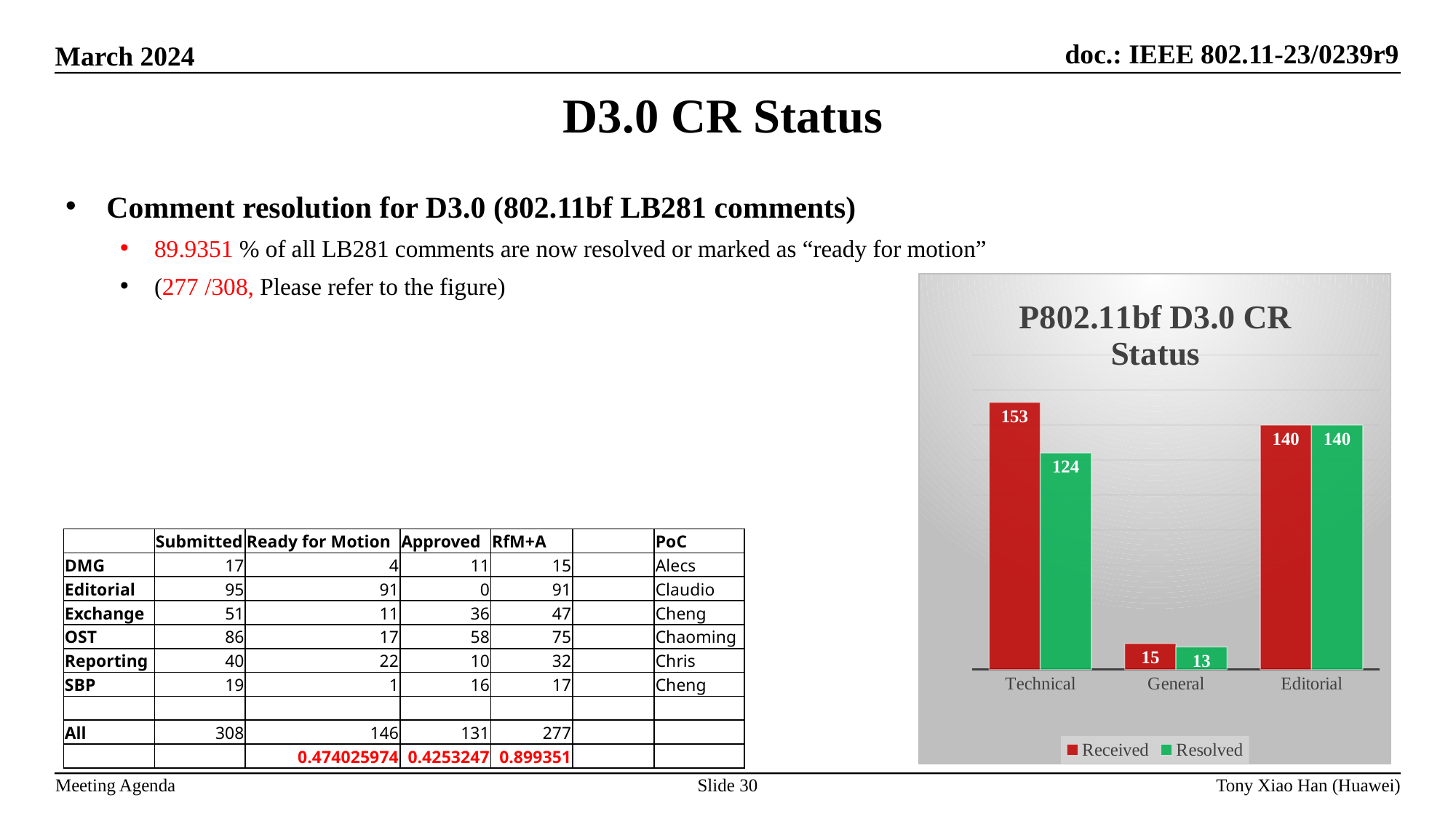
What is the Received value for General? 15 What is the Received value for Technical? 153 Which category has the highest Received value? Technical Which is larger, the Resolved value for Technical or the Resolved value for Editorial? Editorial What is the difference between Received and Resolved for Technical? 29 What is the Resolved value for Technical? 124 What is the Resolved value for Editorial? 140 How many series does the legend list? 2 Which category has the lowest Resolved value? General What is the difference between Received and Resolved for General? 2 How many categories are shown on the x axis? 3 What type of chart is shown? Bar chart